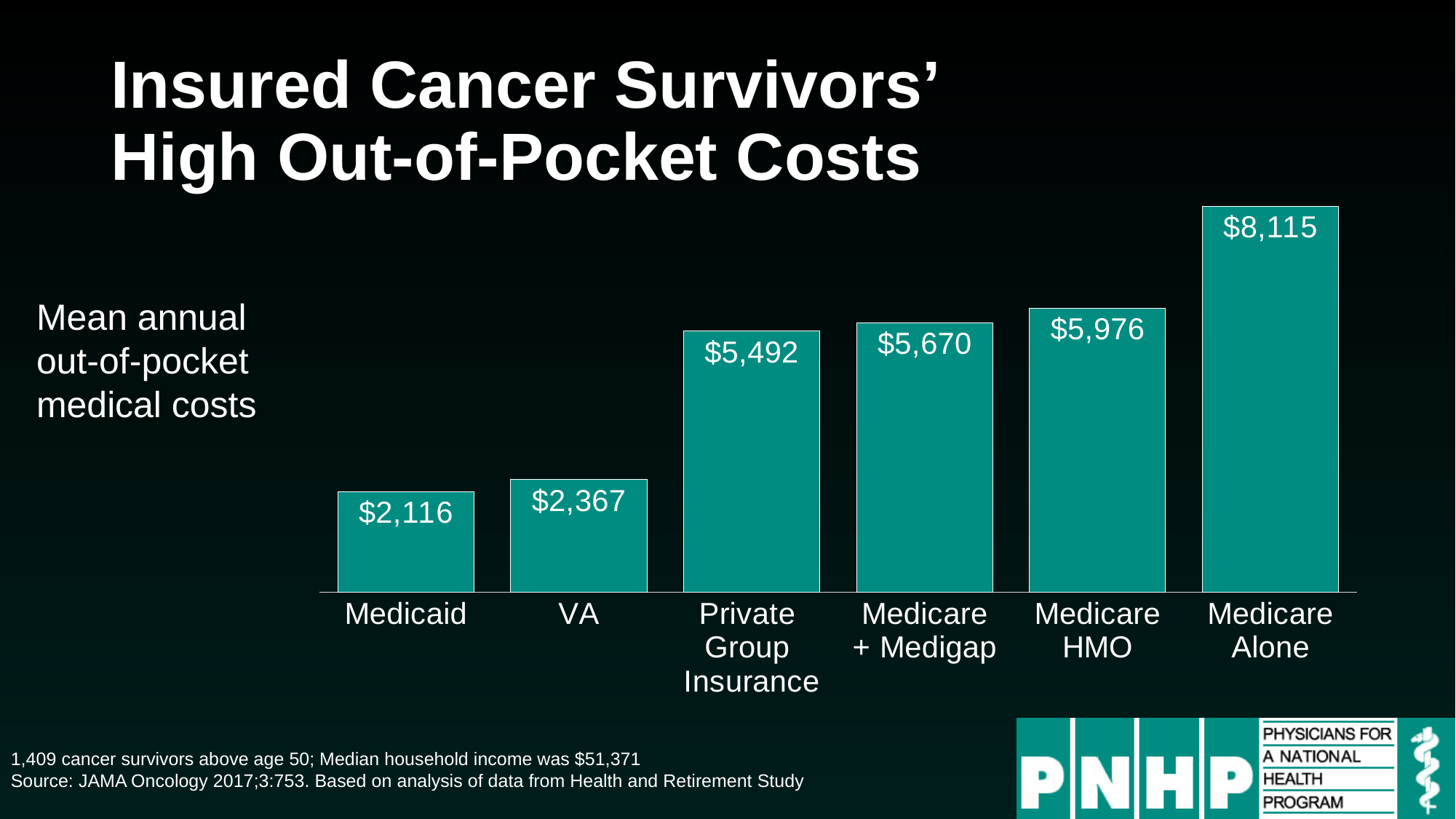
What is the mean annual out-of-pocket medical cost for Medicare HMO? $5,976 Which insurance category has the highest mean annual out-of-pocket medical cost? Medicare Alone What is the difference between the out-of-pocket costs for Medicare Alone and Medicaid? $5,999 Do the values rise or fall moving from left to right across the categories? Rise What kind of chart is shown on the slide? Bar chart What is the mean annual out-of-pocket medical cost for Medicaid? $2,116 What is the difference between the out-of-pocket costs for VA and Medicaid? $251 How many insurance categories are shown in the chart? 6 Which has a higher mean annual out-of-pocket cost, VA or Medicare HMO? Medicare HMO What is the mean annual out-of-pocket medical cost for Private Group Insurance? $5,492 Which has a higher mean annual out-of-pocket cost, Medicare + Medigap or Private Group Insurance? Medicare + Medigap Which insurance category has the lowest mean annual out-of-pocket medical cost? Medicaid